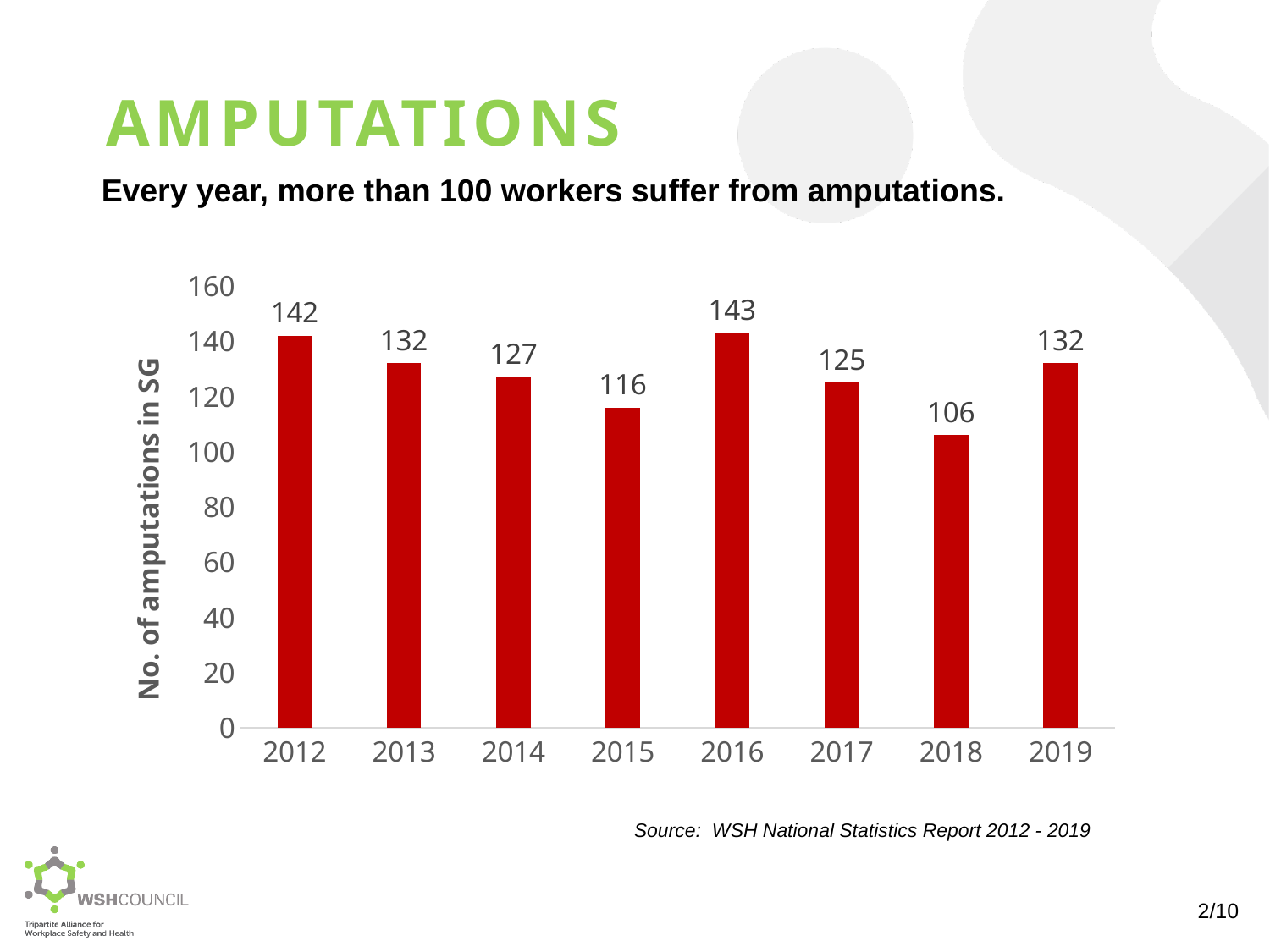
What type of chart is shown on the slide? bar chart What is the number of amputations in 2016? 143 What is the difference between the number of amputations in 2012 and 2015? 26 Is the number of amputations in 2015 greater or less than 120? less What is the number of amputations in 2012? 142 Which year has the highest number of amputations? 2016 Which year has more amputations, 2014 or 2017? 2014 How many years are shown on the x axis of the chart? 8 What is the label of the vertical axis of the chart? No. of amputations in SG What is the difference between the number of amputations in 2016 and 2018? 37 Which year has the lowest number of amputations? 2018 What is the number of amputations in 2018? 106